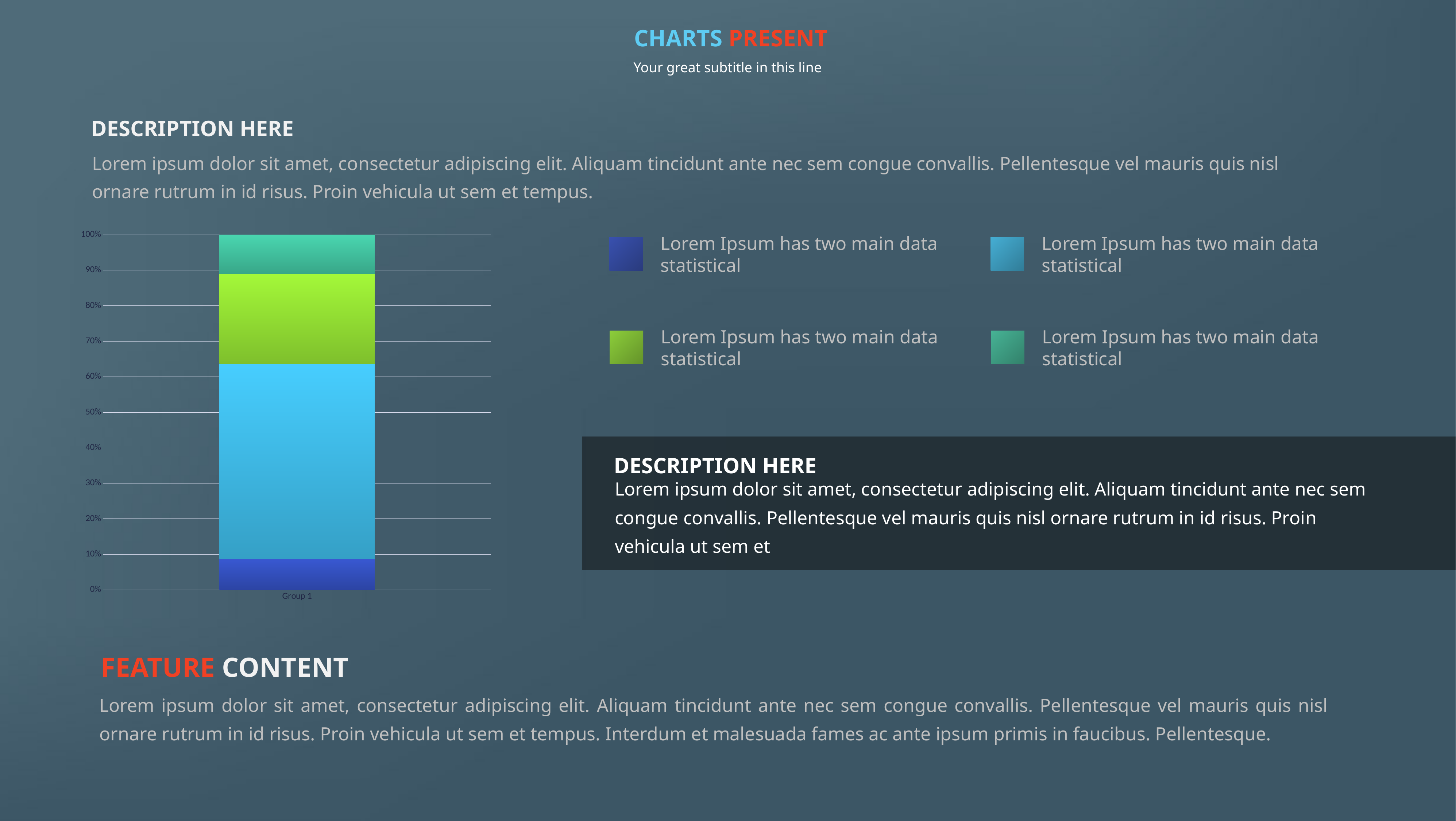
Which is larger in the Group 1 bar, the light blue segment or the green segment? Light blue segment What is the total height of the stacked bar for Group 1 as read from the axis? 100% Which colour segment sits at the top of the Group 1 bar? Teal Which colour segment of the Group 1 bar is the largest? Light blue How many series does the legend list? 4 What is the highest value shown on the vertical axis? 100% What kind of chart is shown on the slide? Stacked bar chart Is the light blue segment of the Group 1 bar greater or less than 50%? greater What is the label of the single category on the x axis? Group 1 Is the green segment of the Group 1 bar greater or less than 20%? greater Is the dark blue segment at the bottom of the Group 1 bar greater or less than 10%? less How many categories are plotted on the x axis of the chart? 1